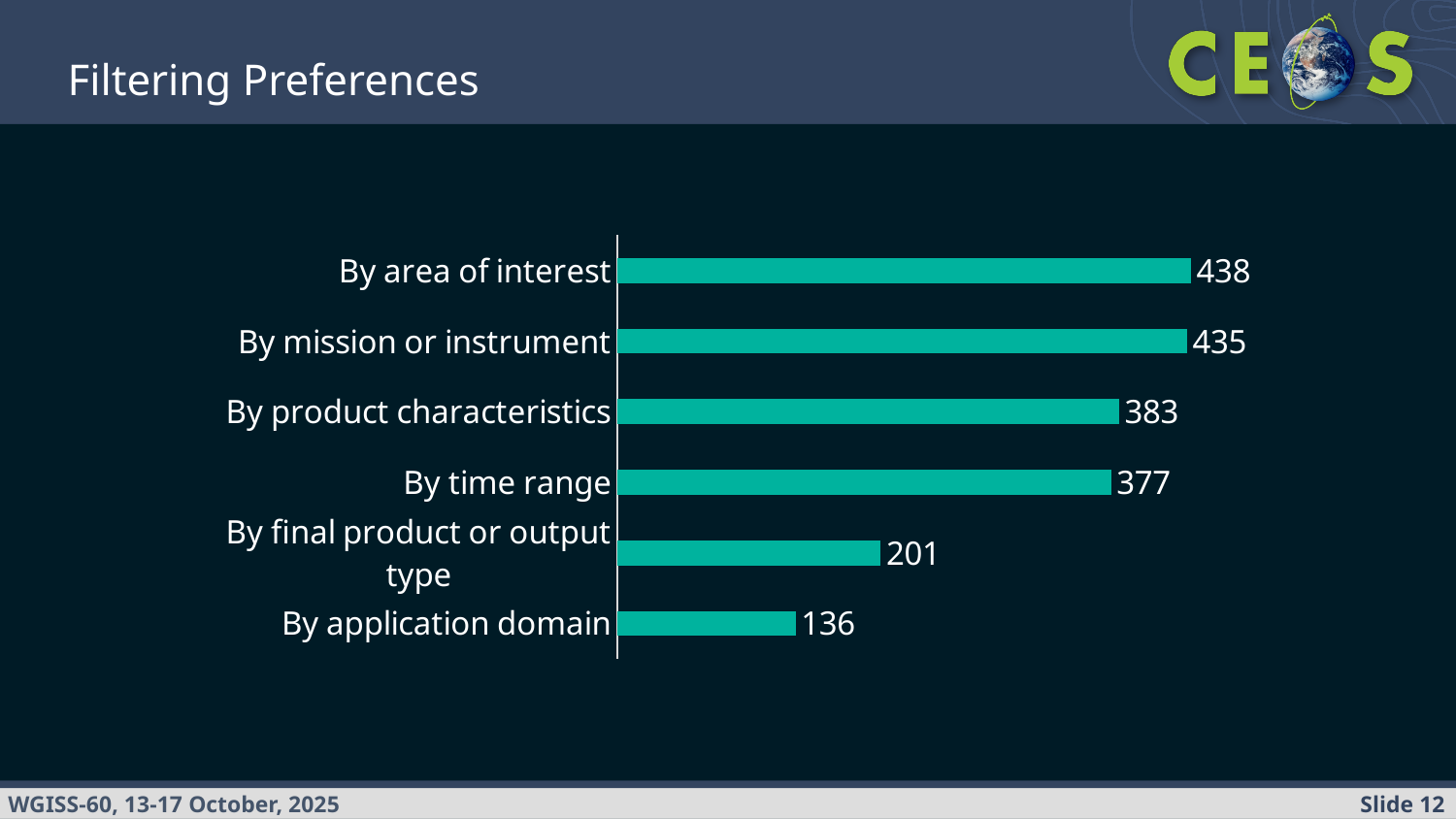
What is the value for "By area of interest"? 438 What is the value for "By application domain"? 136 Which category has the lowest value? By application domain How many categories are shown in the chart? 6 What kind of chart is shown on the slide? Bar chart What is the title of the slide containing the chart? Filtering Preferences What is the value for "By final product or output type"? 201 What is the difference between the values for "By area of interest" and "By application domain"? 302 What is the difference between the values for "By product characteristics" and "By time range"? 6 What is the value for "By time range"? 377 Which is larger, the value for "By final product or output type" or the value for "By application domain"? By final product or output type Which category has the highest value? By area of interest